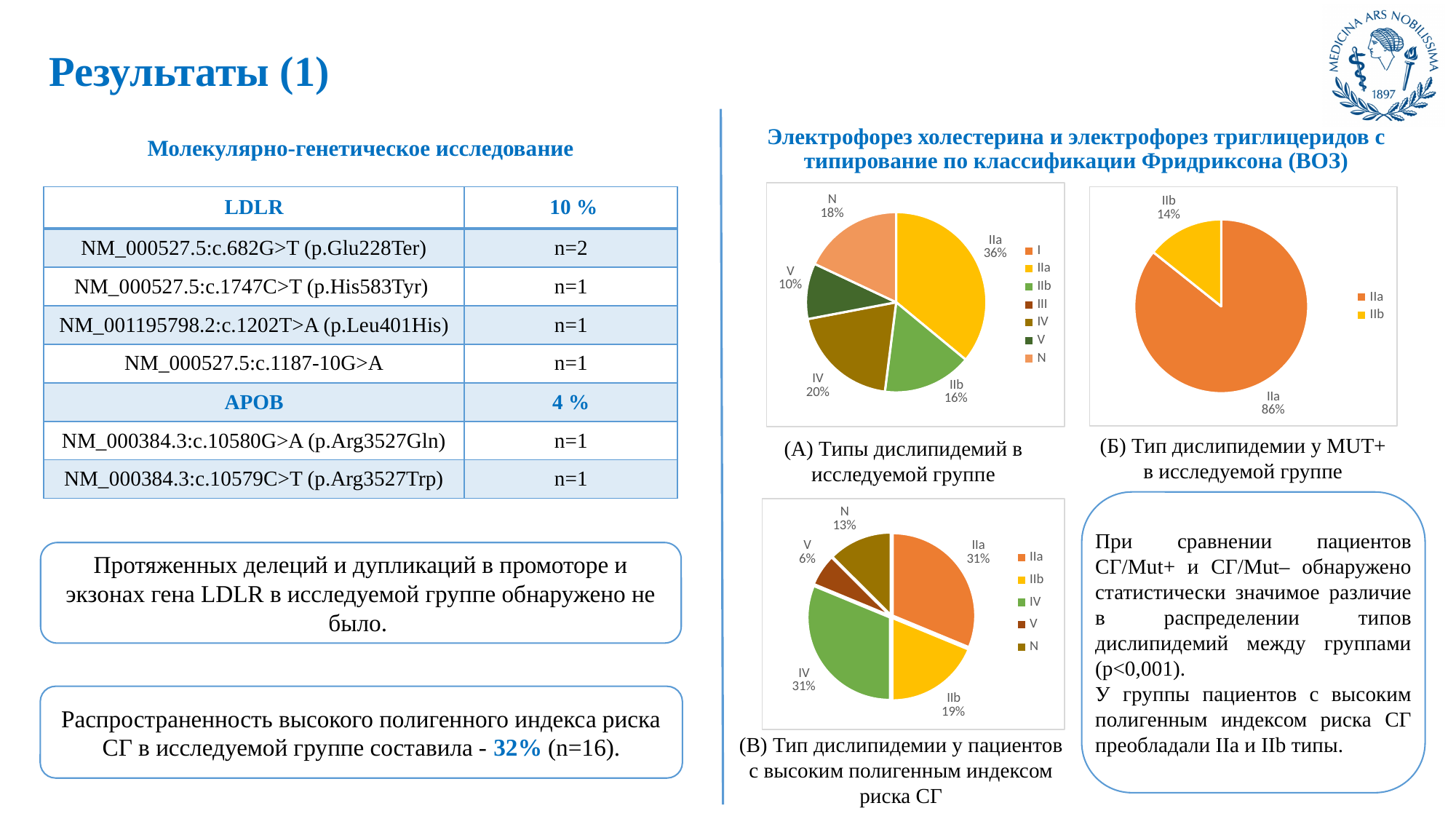
In chart (Б) Тип дислипидемии у MUT+ в исследуемой группе, how many slices are there? 2 In chart (А) Типы дислипидемий в исследуемой группе, what share does type IIa have? 36% In chart (А) Типы дислипидемий в исследуемой группе, what is the difference between the shares of IV and IIb? 4% What kind of chart is chart (В) Тип дислипидемии у пациентов с высоким полигенным индексом риска СГ? Pie chart In chart (В) Тип дислипидемии у пациентов с высоким полигенным индексом риска СГ, what share does type IIb have? 19% In chart (В) Тип дислипидемии у пациентов с высоким полигенным индексом риска СГ, which type has the smallest share? V In chart (Б) Тип дислипидемии у MUT+ в исследуемой группе, what share does type IIa have? 86% In chart (А) Типы дислипидемий в исследуемой группе, which type has the largest share? IIa In chart (Б) Тип дислипидемии у MUT+ в исследуемой группе, what share does type IIb have? 14% In chart (А) Типы дислипидемий в исследуемой группе, which labelled slice has the smallest share? V In chart (В) Тип дислипидемии у пациентов с высоким полигенным индексом риска СГ, which is larger, the share of N or the share of V? N In chart (А) Типы дислипидемий в исследуемой группе, how many entries does the legend list? 7